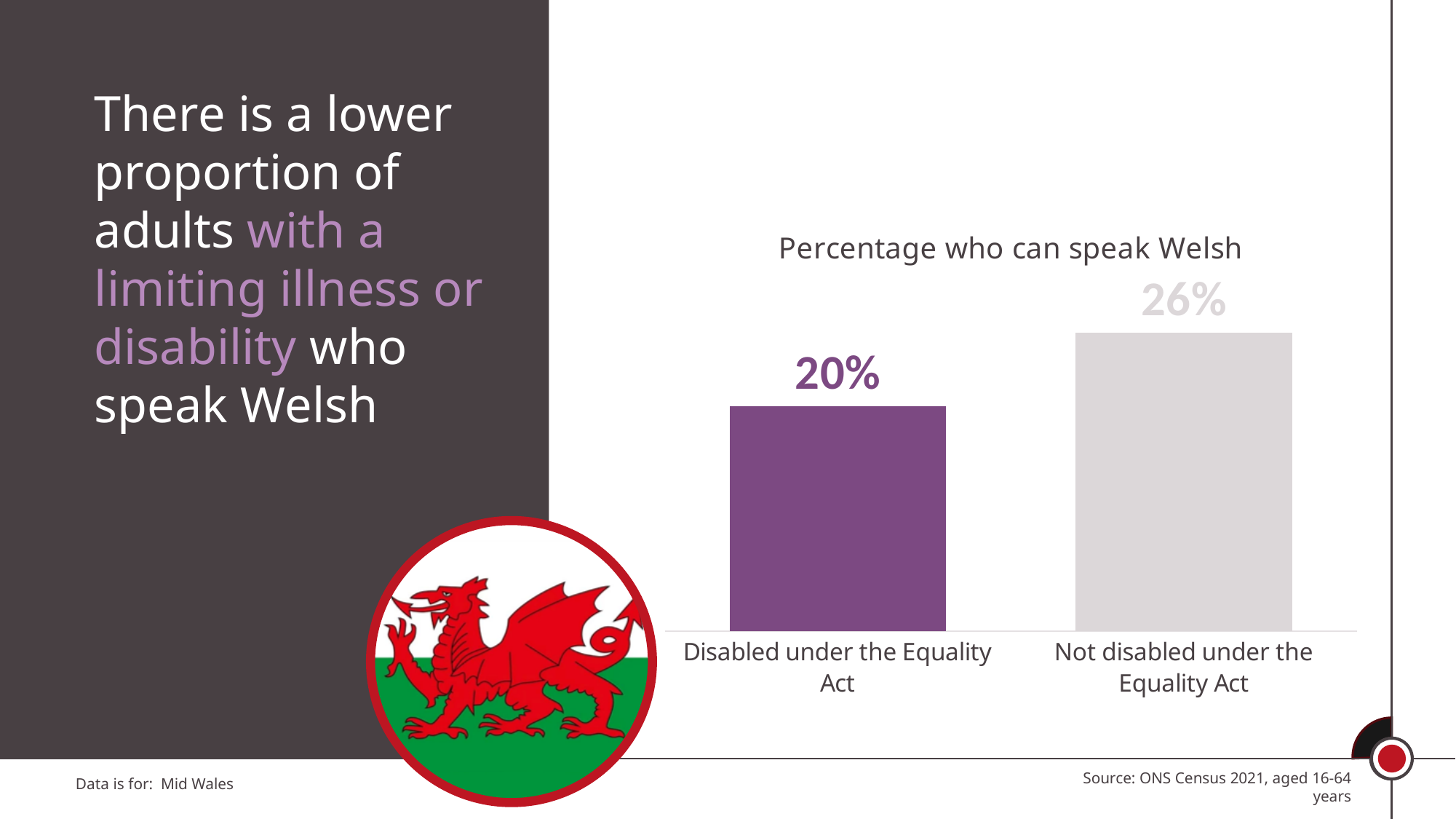
What is the difference in percentage points between the two categories shown in the chart? 6 percentage points How many categories are shown in the chart? 2 What is the title of the chart? Percentage who can speak Welsh Is the value for 'Disabled under the Equality Act' larger or smaller than the value for 'Not disabled under the Equality Act'? smaller What is the percentage who can speak Welsh for adults disabled under the Equality Act? 20% What kind of chart is shown on the slide? bar chart Which area does the data on the slide cover? Mid Wales What is the percentage who can speak Welsh for adults not disabled under the Equality Act? 26% What colour is the bar for 'Disabled under the Equality Act'? purple Which category has the lower percentage who can speak Welsh? Disabled under the Equality Act Which category has the higher percentage who can speak Welsh? Not disabled under the Equality Act